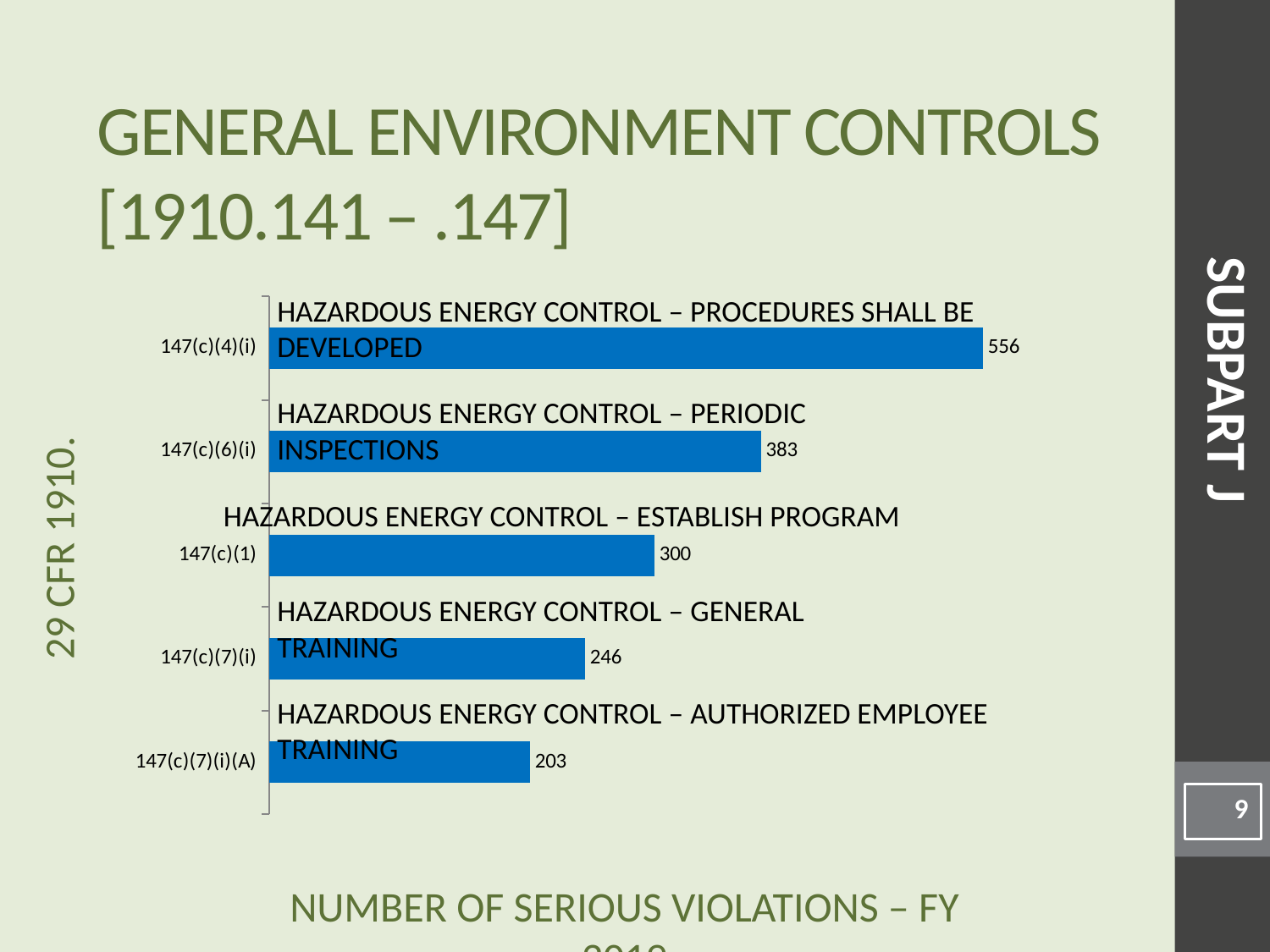
Which category has the lowest number of serious violations? 147(c)(7)(i)(A) What is the difference in serious violations between 147(c)(4)(i) and 147(c)(6)(i)? 173 Which category has the highest number of serious violations? 147(c)(4)(i) How many categories are shown in the chart? 5 What is the number of serious violations for 147(c)(1)? 300 What is the number of serious violations for 147(c)(4)(i)? 556 What is the title of the slide? GENERAL ENVIRONMENT CONTROLS [1910.141 – .147] What is the number of serious violations for 147(c)(7)(i)(A)? 203 What is the number of serious violations for 147(c)(7)(i)? 246 Which has more serious violations, 147(c)(1) or 147(c)(7)(i)? 147(c)(1) What is the number of serious violations for 147(c)(6)(i)? 383 What type of chart is shown on the slide? Bar chart